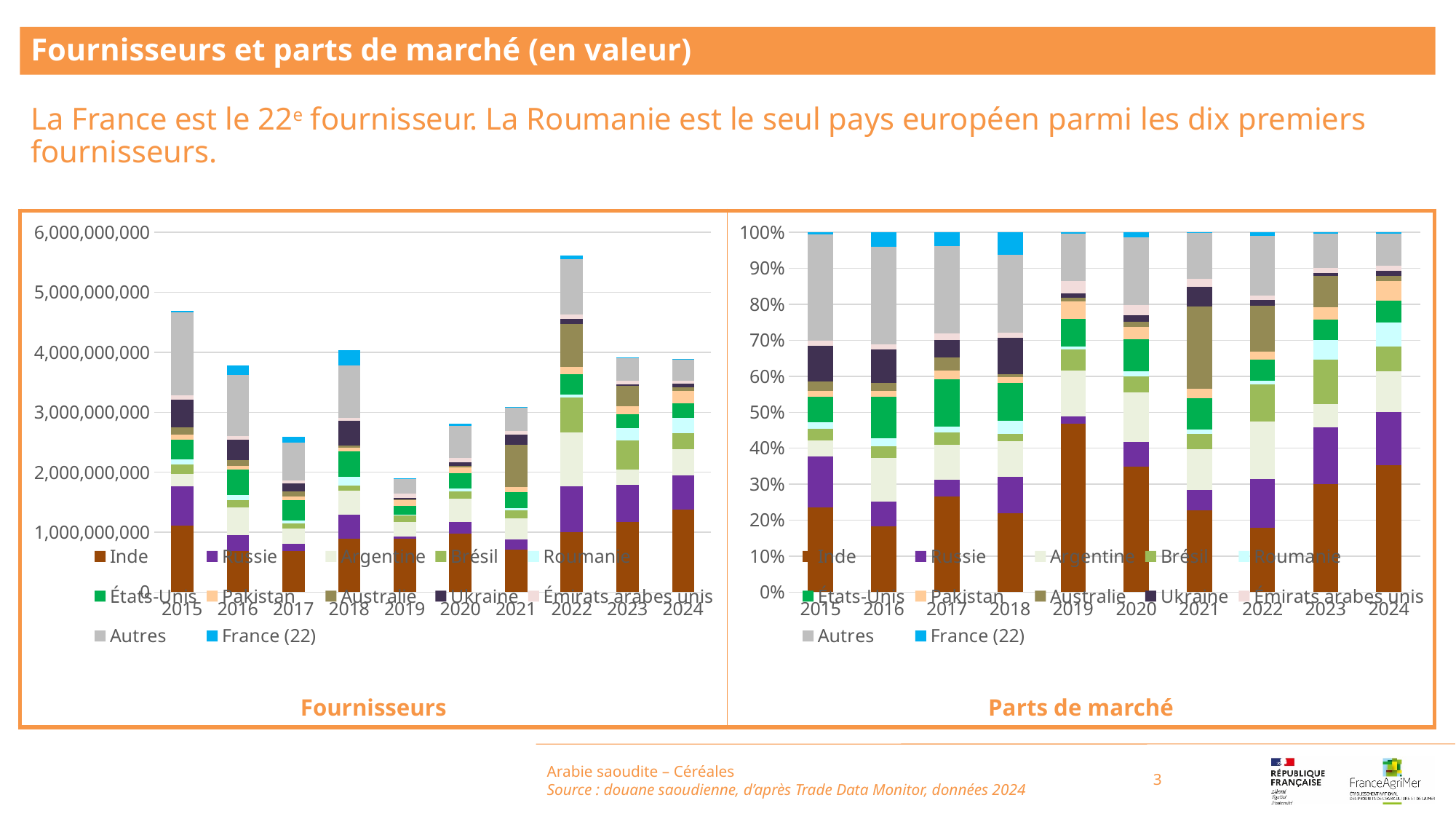
How many years are shown on the x axis of the 'Fournisseurs' chart? 10 How many series does the legend of the 'Parts de marché' chart list? 12 Which legend entry in the 'Fournisseurs' chart is shown in light blue and includes a rank in parentheses? France (22) In the 'Fournisseurs' chart, is the total for 2015 greater or less than 4,000,000,000? greater In the 'Fournisseurs' chart, which year has the larger total bar, 2022 or 2023? 2022 In the 'Fournisseurs' chart, which year has the lowest total bar? 2019 In the 'Fournisseurs' chart, which year has the highest total bar? 2022 In the 'Fournisseurs' chart, is the total for 2022 greater or less than 5,000,000,000? greater In the 'Parts de marché' chart, is the share of Inde in 2019 greater or less than 40%? greater In the 'Parts de marché' chart, which year has the larger share for Inde, 2016 or 2019? 2019 What kind of chart is the 'Fournisseurs' chart on the left? stacked bar chart